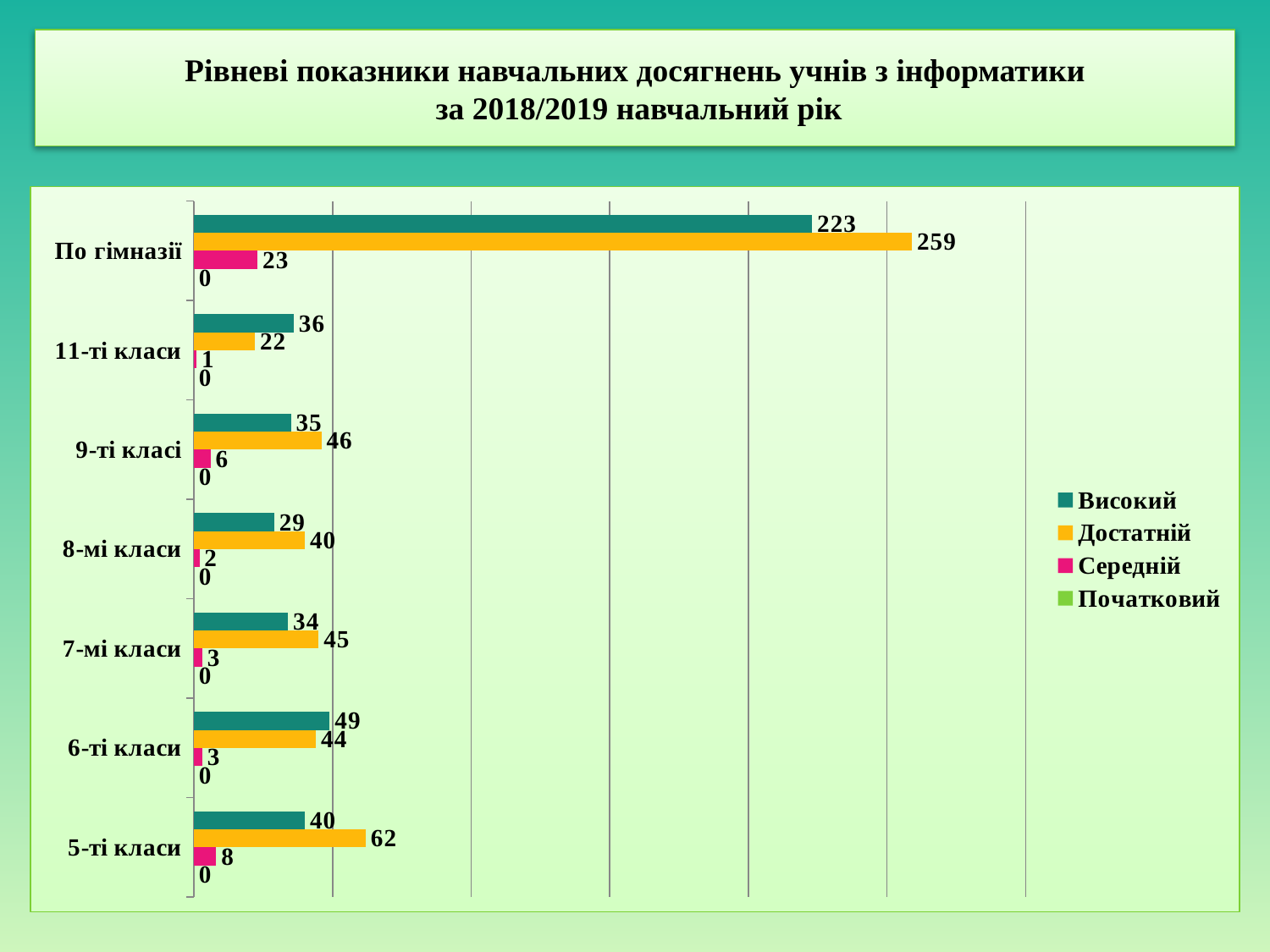
What is the value of Середній for 5-ті класи? 8 What is the value of Високий for 6-ті класи? 49 How many categories are shown on the vertical axis? 7 For 9-ті класі, which is larger: Високий or Достатній? Достатній Which class category has the highest Достатній value (excluding По гімназії)? 5-ті класи Which class category has the lowest Середній value? 11-ті класи What is the difference between Достатній and Високий for По гімназії? 36 What kind of chart is shown on the slide? bar chart How many series does the legend list? 4 What is the value of Початковий for 7-мі класи? 0 What is the value of Достатній for По гімназії? 259 Which series is shown in pink/magenta in the legend? Середній